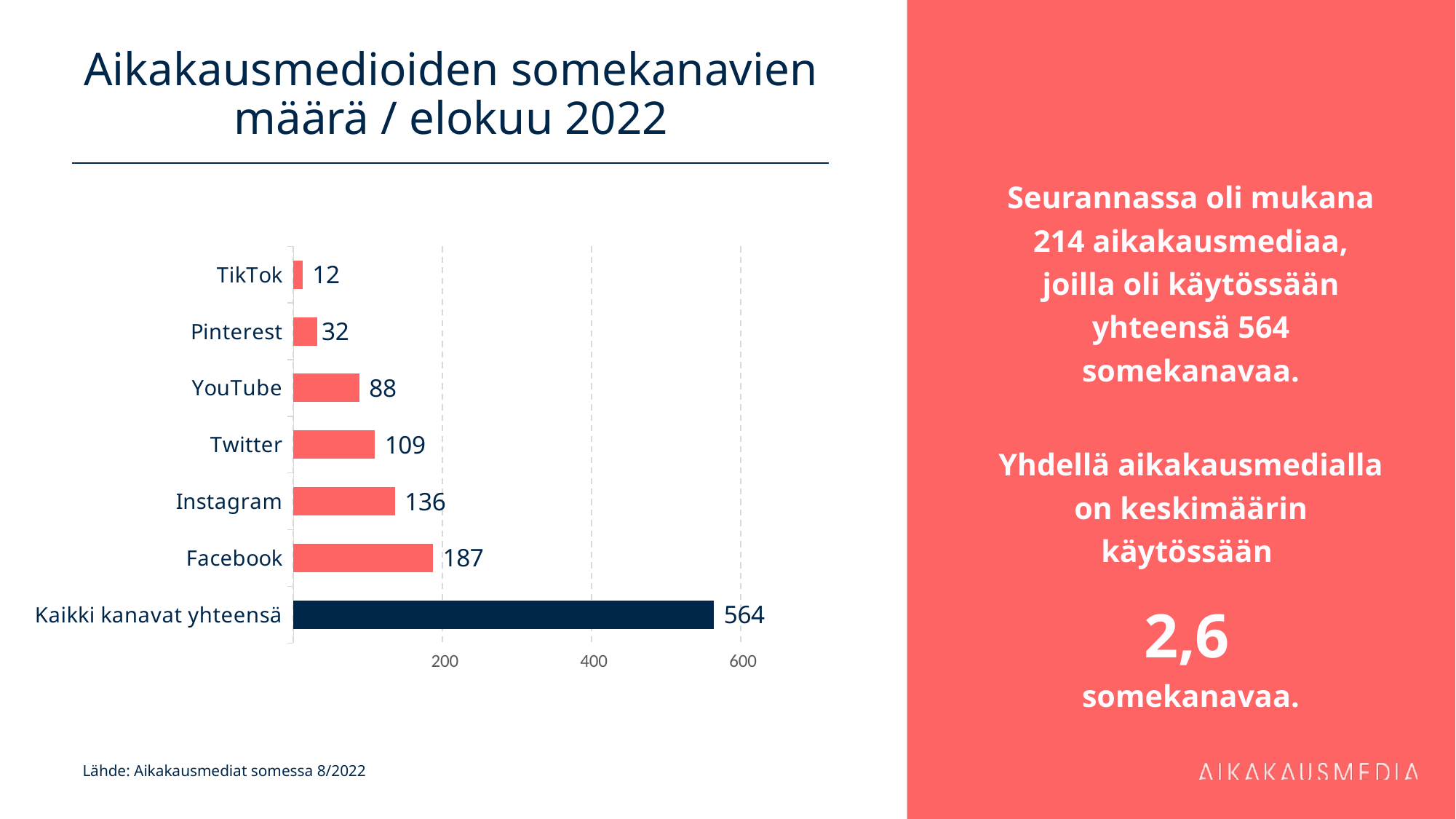
Which category has the lowest value? TikTok What is the value for TikTok? 12 Which individual channel (excluding the total bar) has the highest value? Facebook What kind of chart is shown on the slide? bar chart Is the value for Instagram greater or less than 200? less What is the difference between the values for Facebook and Instagram? 51 What is the value for Kaikki kanavat yhteensä? 564 How many categories are shown in the chart? 7 What is the value for Facebook? 187 What is the title of the chart? Aikakausmedioiden somekanavien määrä / elokuu 2022 What is the difference between the values for Pinterest and TikTok? 20 Which is larger, the value for Twitter or the value for YouTube? Twitter